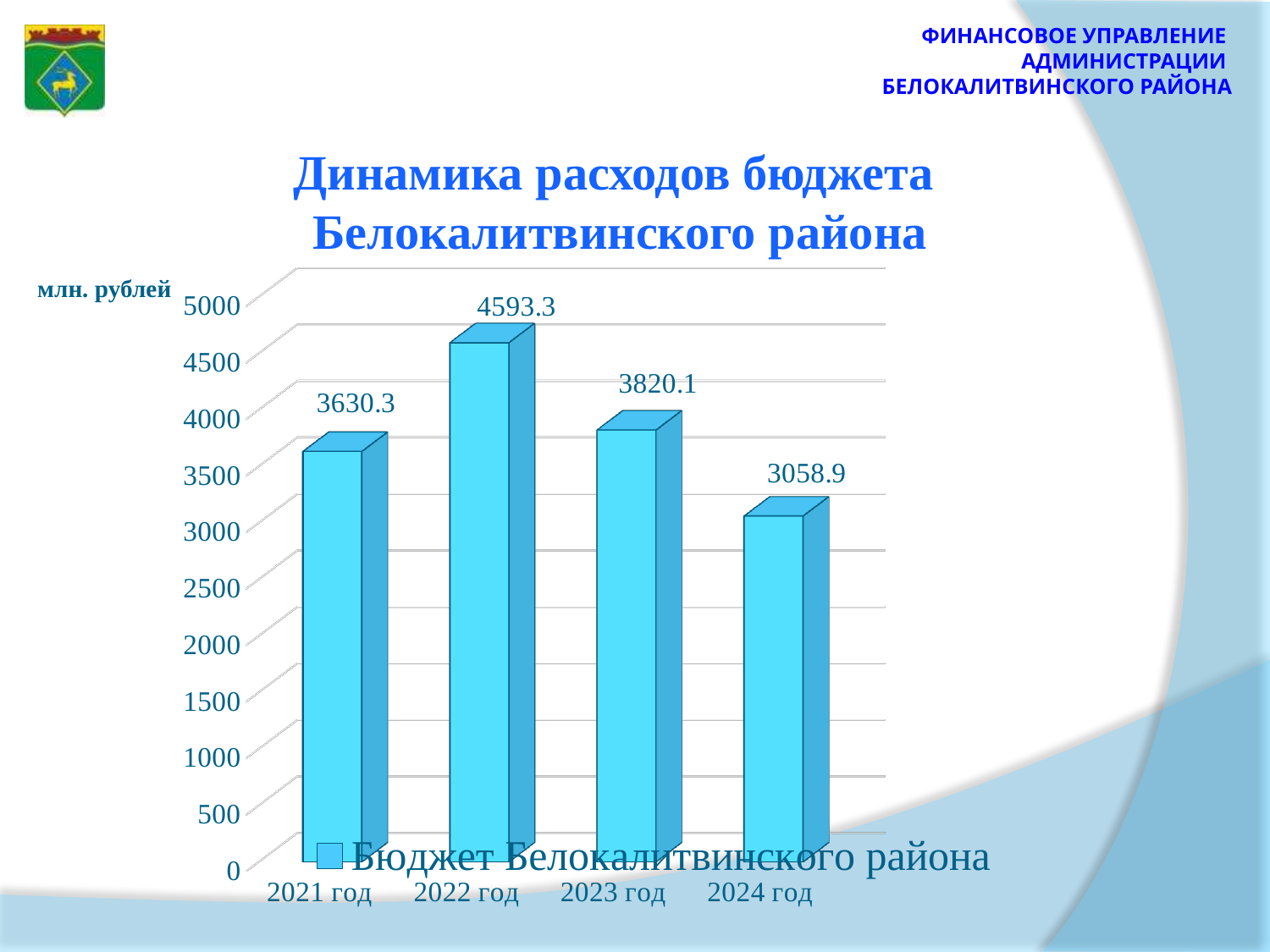
What is the value for 2022 год? 4593.3 Which year has the highest value? 2022 год How many years are shown on the chart? 4 What unit is shown on the vertical axis label? млн. рублей Is the value for 2024 год greater or less than 3500? less What is the value for 2023 год? 3820.1 What is the value for 2024 год? 3058.9 What kind of chart is shown on the slide? bar chart Which year has the lowest value? 2024 год What is the value for 2021 год? 3630.3 Which is larger, the value for 2021 год or the value for 2023 год? 2023 год What is the difference between the values for 2022 год and 2023 год? 773.2